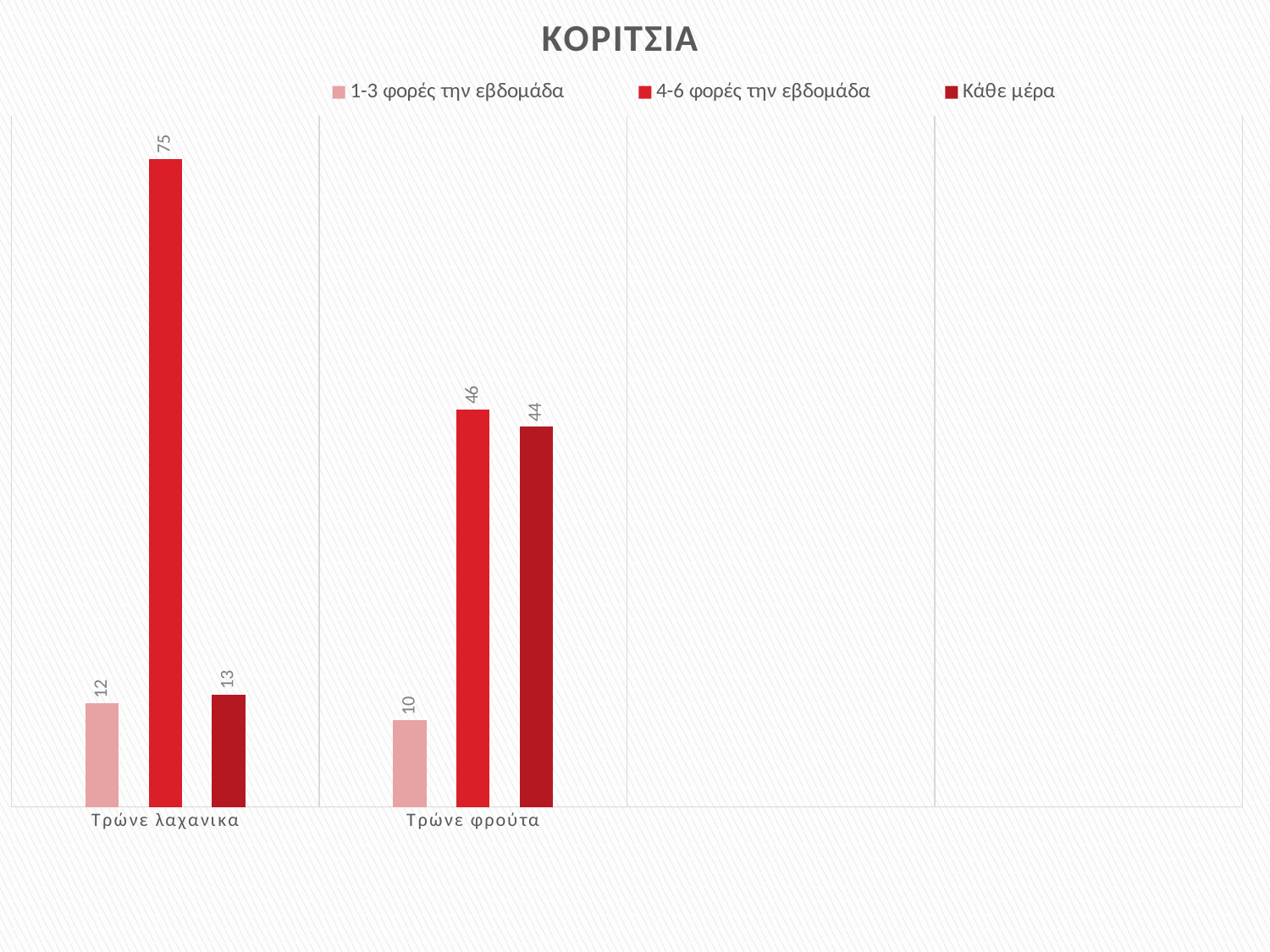
Which series has the lowest value in the 'Τρώνε φρούτα' category? 1-3 φορές την εβδομάδα Which is larger: the '1-3 φορές την εβδομάδα' value for 'Τρώνε λαχανικα' or for 'Τρώνε φρούτα'? Τρώνε λαχανικα What is the title of the chart? ΚΟΡΙΤΣΙΑ How many series does the legend list? 3 What is the value for 'Κάθε μέρα' in the 'Τρώνε φρούτα' category? 44 What is the value for '4-6 φορές την εβδομάδα' in the 'Τρώνε λαχανικα' category? 75 What is the difference between the '4-6 φορές την εβδομάδα' values for 'Τρώνε λαχανικα' and 'Τρώνε φρούτα'? 29 What kind of chart is shown on the slide? Bar chart What is the value for '1-3 φορές την εβδομάδα' in the 'Τρώνε φρούτα' category? 10 What is the value for 'Κάθε μέρα' in the 'Τρώνε λαχανικα' category? 13 How many categories are shown on the x axis? 2 Which series has the highest value in the 'Τρώνε λαχανικα' category? 4-6 φορές την εβδομάδα